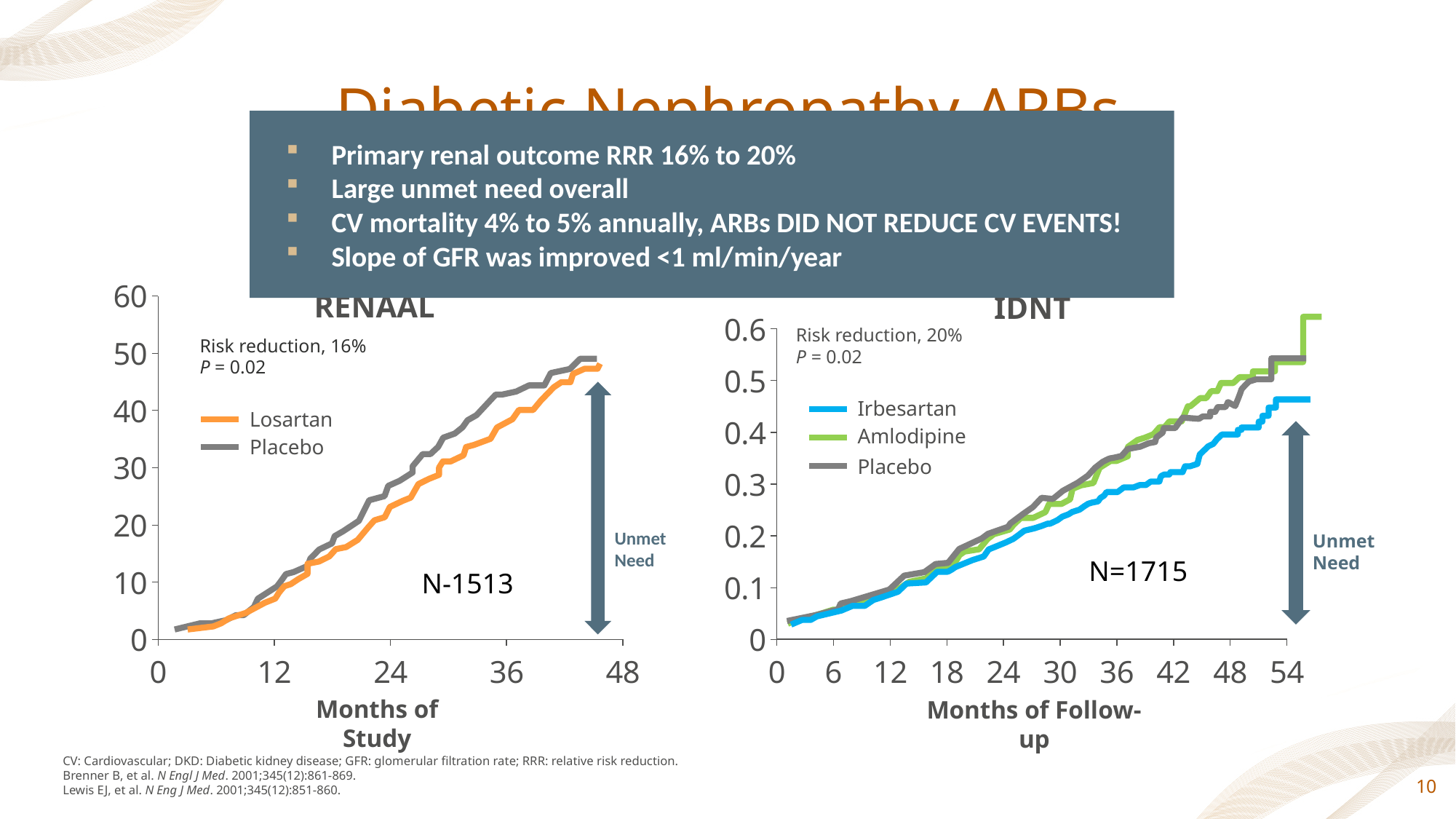
How many series does the legend of the IDNT chart list? 3 In the RENAAL chart, is the Placebo value at 24 months greater or less than 20? greater In the IDNT chart, which series is lowest at the end of follow-up? Irbesartan In the RENAAL chart, is the Losartan value at 36 months greater or less than 30? greater In the IDNT chart, is the Amlodipine value at 54 months greater or less than 0.5? greater How many series does the legend of the RENAAL chart list? 2 What kind of chart is the RENAAL chart on the left? line chart In the IDNT chart, do the Irbesartan values rise or fall as months of follow-up increase? rise In the RENAAL chart, do the Losartan values rise or fall as months of study increase? rise In the RENAAL chart, which series is higher at 36 months, Losartan or Placebo? Placebo What risk reduction is stated on the IDNT chart? 20%